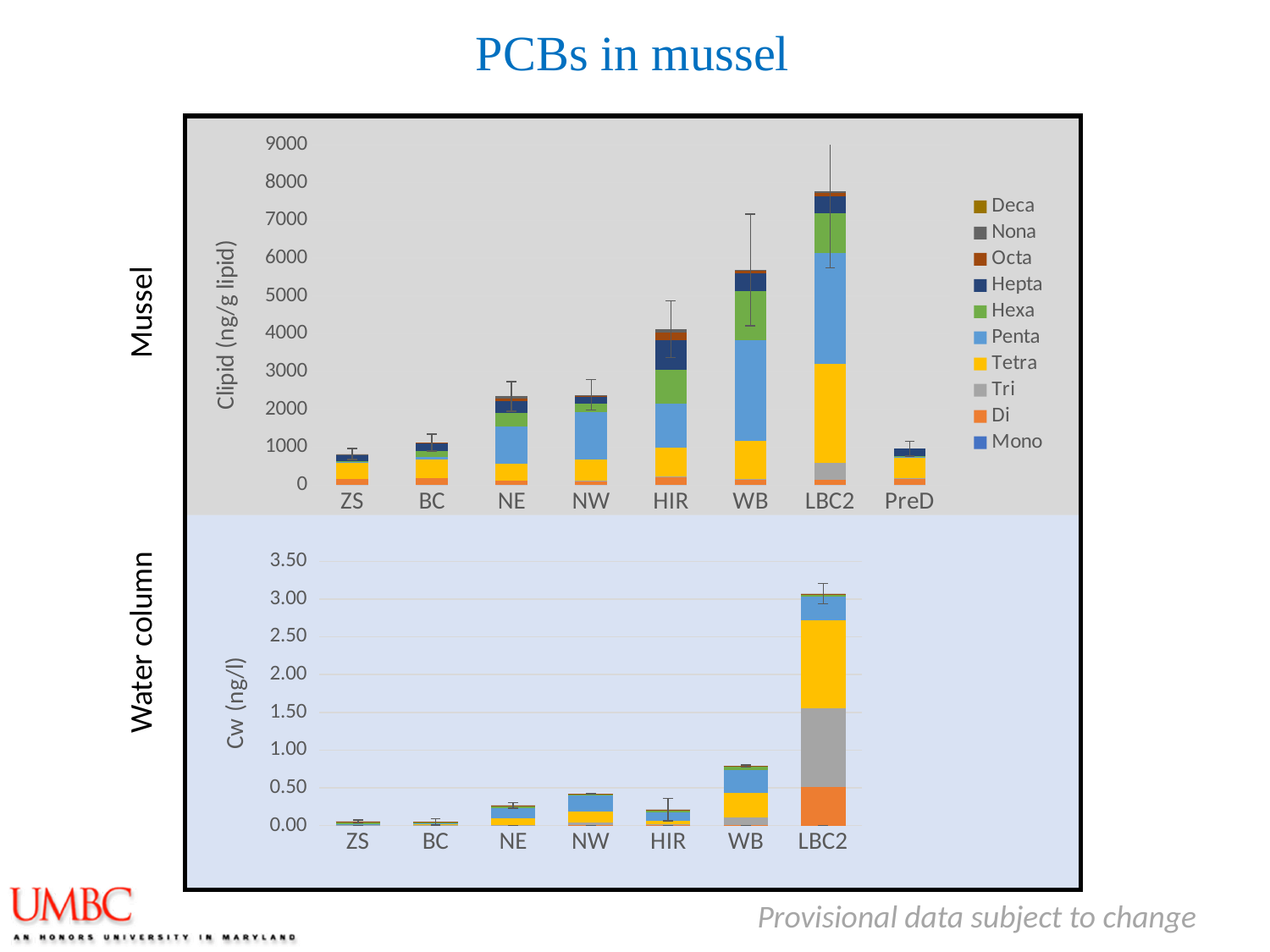
What is the y-axis label of the Water column chart at the bottom? Cw (ng/l) In the Mussel chart at the top, is the total for HIR greater or less than 5000? less In the Water column chart at the bottom, is the total for WB greater or less than 1.00? less In the Water column chart at the bottom, which category has the highest total bar? LBC2 How many categories are shown on the x axis of the Water column chart at the bottom? 7 In the Mussel chart at the top, which category has the highest total bar? LBC2 How many series does the legend list? 10 In the Mussel chart at the top, which has the larger total bar, WB or HIR? WB What kind of chart is the Mussel chart at the top of the slide? stacked bar chart In the Water column chart at the bottom, which has the larger total bar, WB or NW? WB In the Mussel chart at the top, is the total for LBC2 greater or less than 7000? greater How many categories are shown on the x axis of the Mussel chart at the top? 8